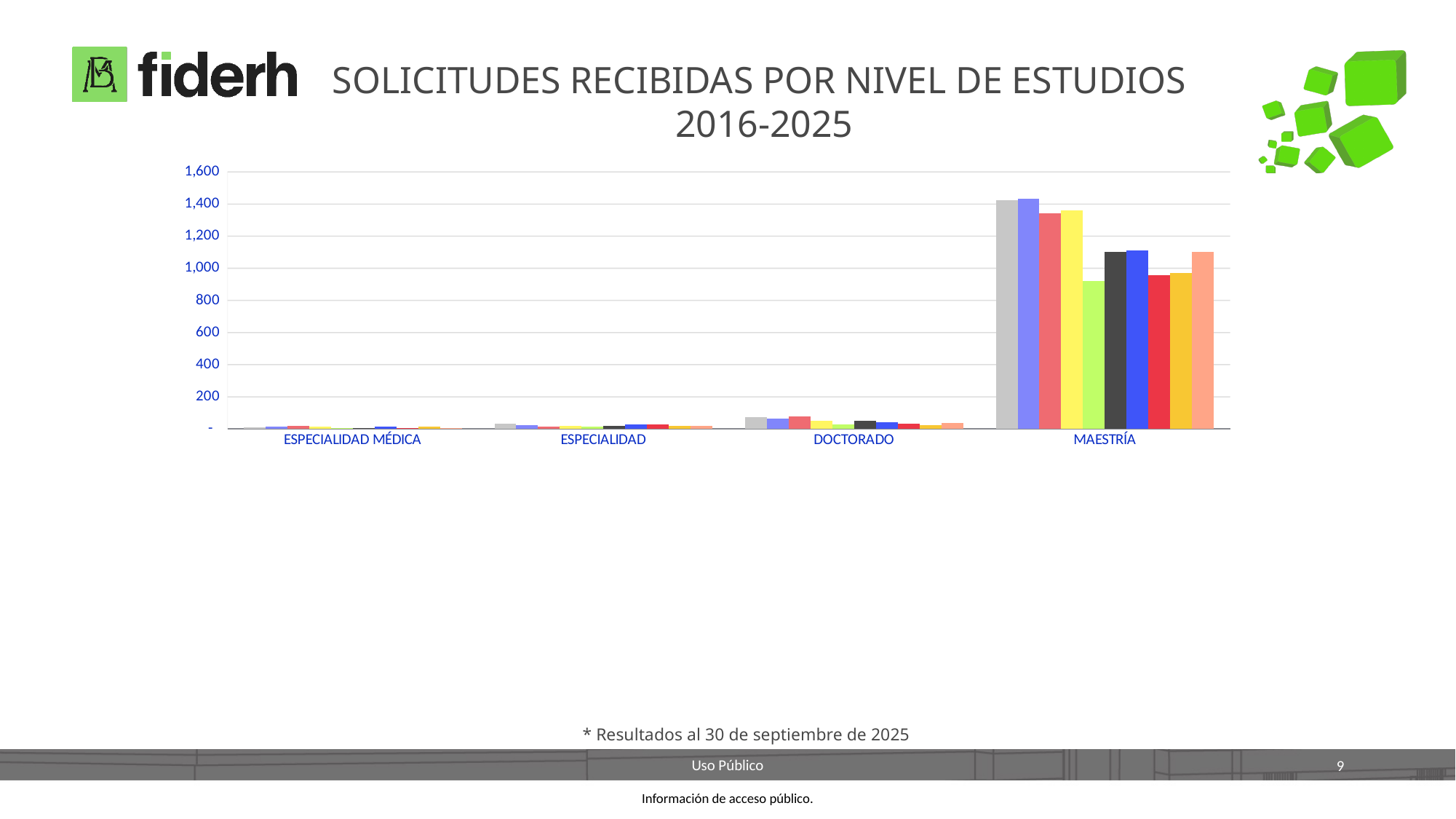
Are all the bars for MAESTRÍA greater or less than 800? greater Is the tallest bar for MAESTRÍA greater or less than 1,600? less What is the highest value shown on the y axis? 1,600 Are all the bars for ESPECIALIDAD greater or less than 200? less Which study level has the highest number of applications received? MAESTRÍA Which has more applications received, DOCTORADO or MAESTRÍA? MAESTRÍA Which study level has the lowest number of applications received? ESPECIALIDAD MÉDICA What is the title of the chart? SOLICITUDES RECIBIDAS POR NIVEL DE ESTUDIOS 2016-2025 How many bars are plotted for each study level? 10 How many study-level categories are shown on the x axis? 4 What kind of chart is shown on the slide? bar chart